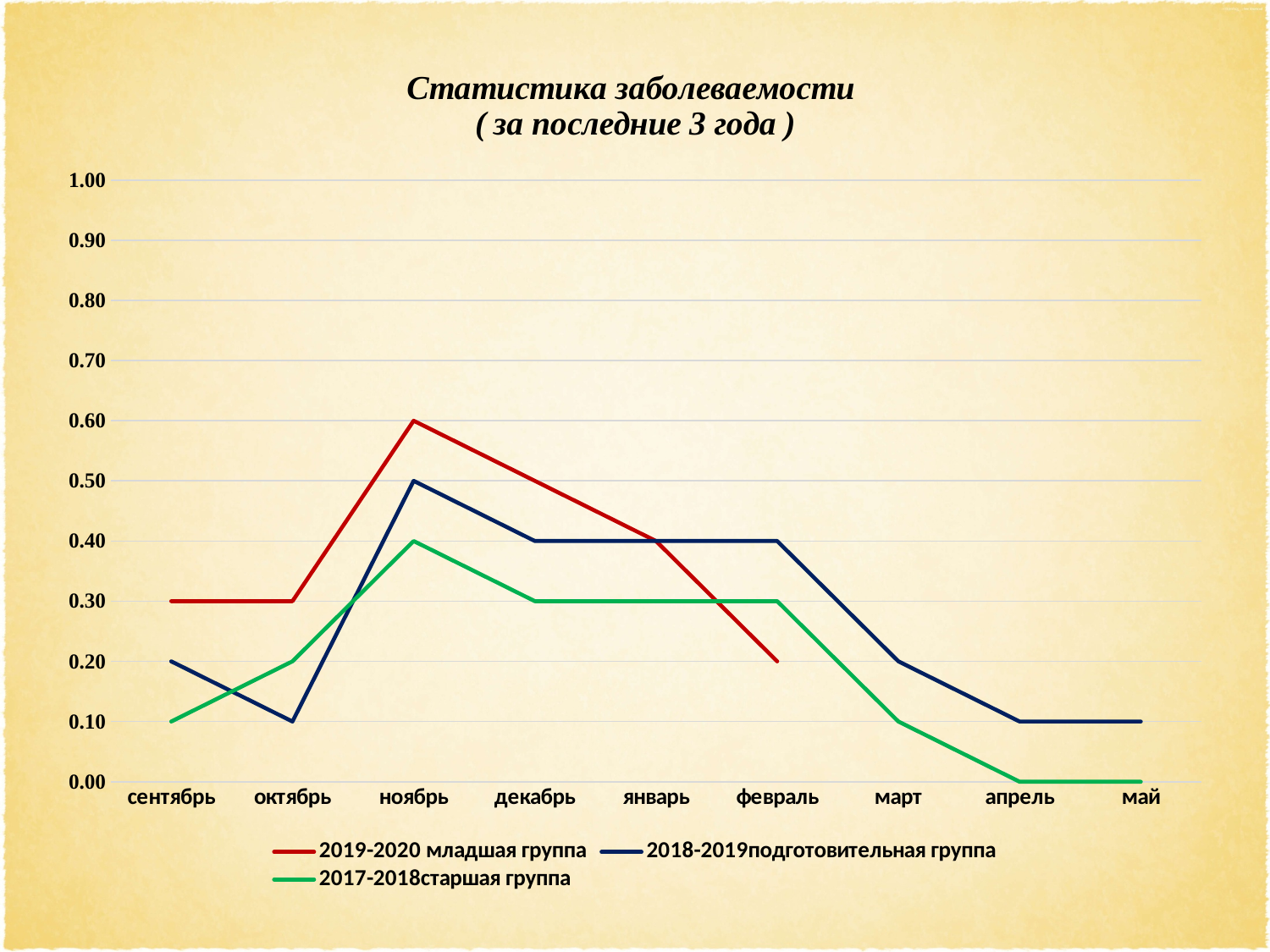
Does the 2017-2018 старшая группа series rise or fall from февраль to апрель? fall In which month does the 2019-2020 младшая группа series reach its highest value? ноябрь In which month does the 2018-2019 подготовительная группа series have its lowest value? октябрь, апрель, май What is the value for 2017-2018 старшая группа in ноябрь? 0.40 Which is larger in сентябрь: the value for 2019-2020 младшая группа or for 2017-2018 старшая группа? 2019-2020 младшая группа What is the title of the chart? Статистика заболеваемости ( за последние 3 года ) What is the difference between the 2019-2020 младшая группа and 2017-2018 старшая группа values in ноябрь? 0.20 What kind of chart is shown on the slide? line chart What is the value for 2018-2019 подготовительная группа in октябрь? 0.10 How many months are shown along the x axis? 9 How many series does the legend list? 3 What is the value for 2019-2020 младшая группа in ноябрь? 0.60